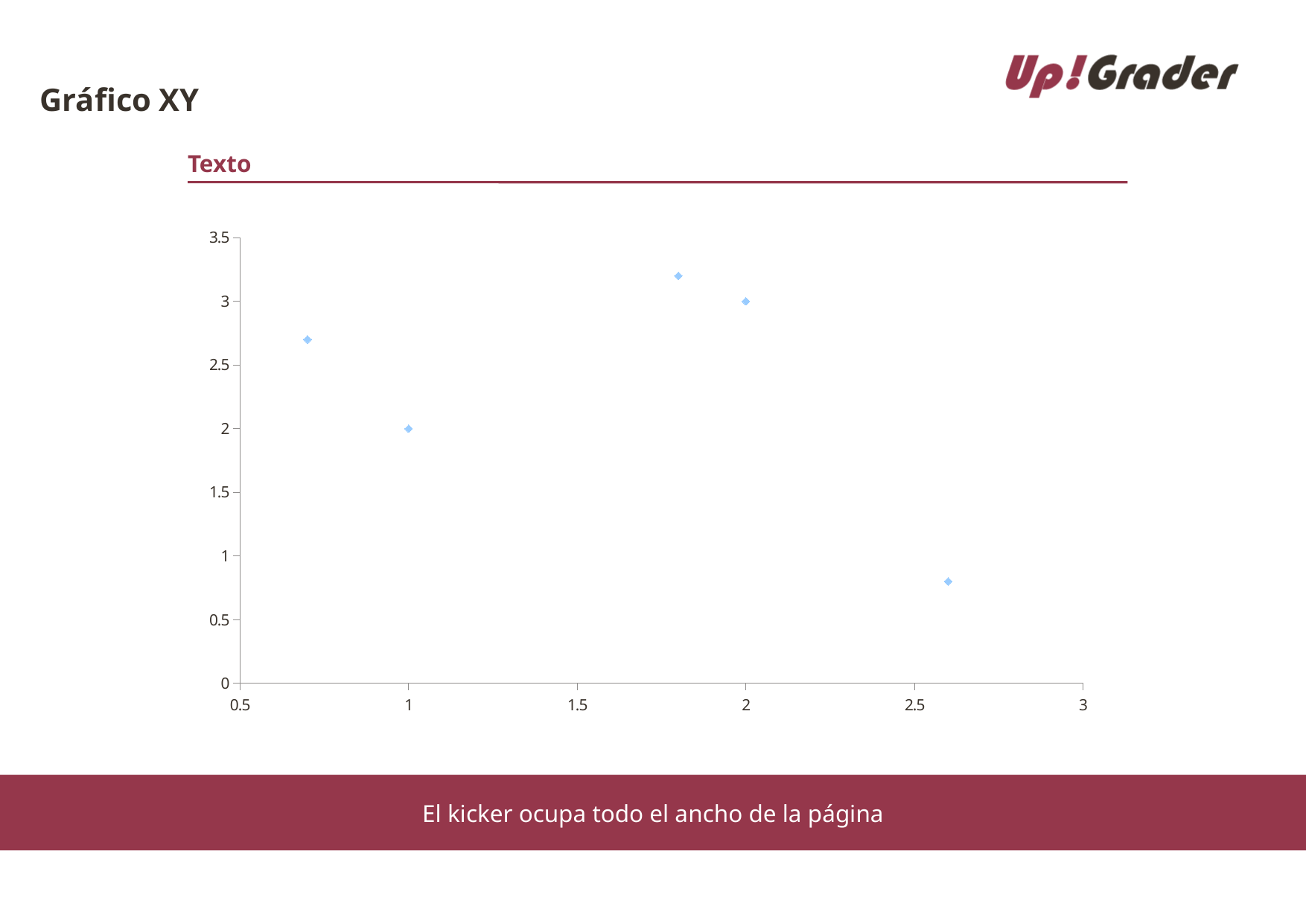
Is the y value of the point near x = 1.8 greater or less than 3? greater What is the maximum value shown on the y axis? 3.5 Which point has the lowest y value: the one near x = 2.6 or the one near x = 1? the one near x = 2.6 What is the minimum value shown on the x axis? 0.5 Is the y value of the point near x = 2.6 greater or less than 1? less Is the y value of the point near x = 0.7 greater or less than 2.5? greater What kind of chart is shown on the slide? scatter chart How many data points are plotted on the chart? 5 What is the y value of the point plotted at x = 2? 3 Which point has the larger y value: the one at x = 1 or the one at x = 2? the one at x = 2 What is the y value of the point plotted at x = 1? 2